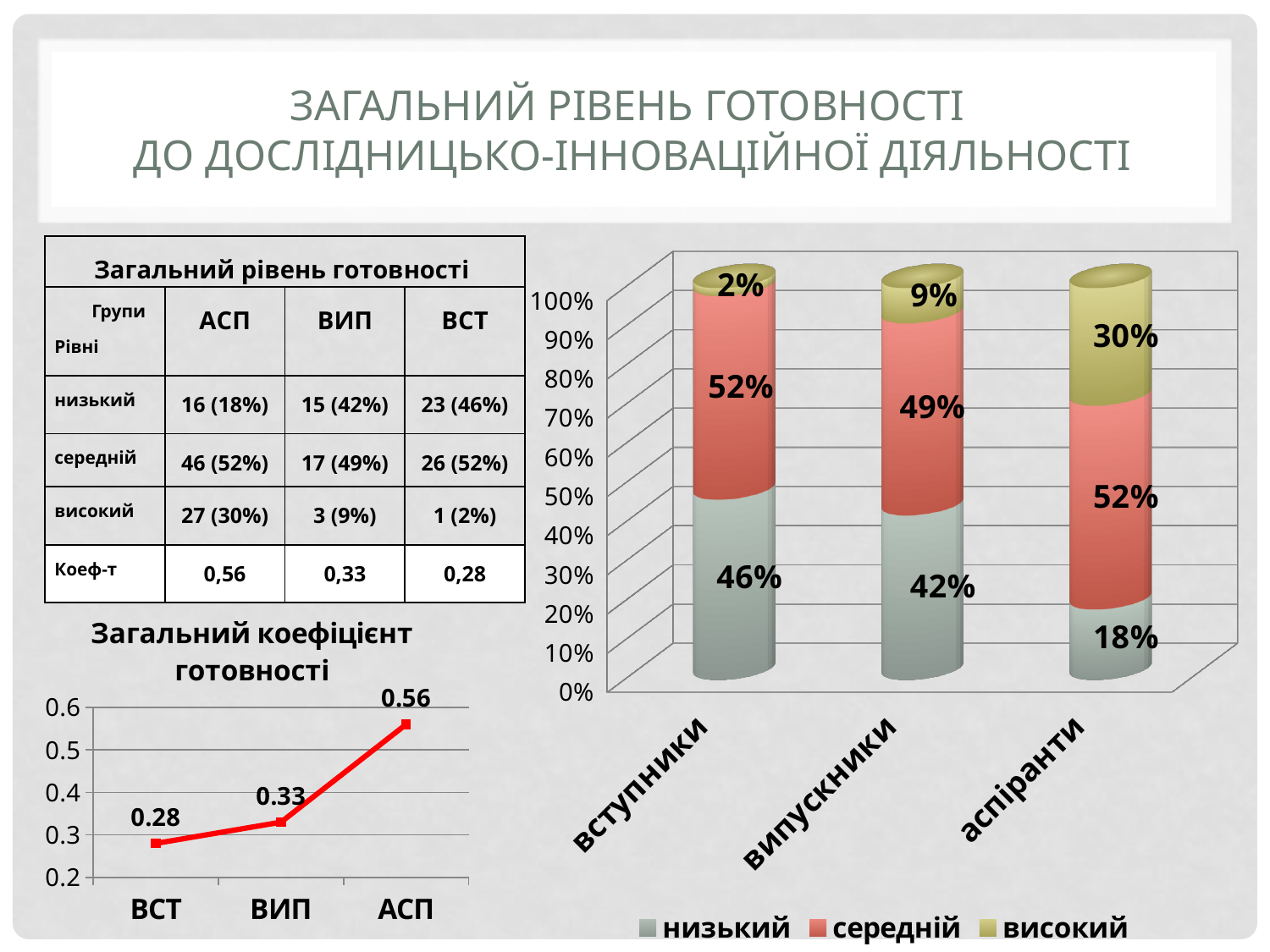
What kind of chart is the chart on the right of the slide? stacked bar chart In the line chart 'Загальний коефіцієнт готовності', how many points are plotted? 3 In the stacked bar chart on the right, what is the value of 'високий' for аспіранти? 30% In the stacked bar chart on the right, which group has the lowest 'високий' share? вступники In the stacked bar chart on the right, how many series does the legend list? 3 In the stacked bar chart on the right, is the 'низький' value larger for випускники or for аспіранти? випускники In the line chart 'Загальний коефіцієнт готовності', which group has the highest value? АСП In the line chart 'Загальний коефіцієнт готовності', what is the difference between the values for АСП and ВИП? 0.23 In the stacked bar chart on the right, what is the value of 'низький' for вступники? 46% In the line chart 'Загальний коефіцієнт готовності', do the values rise or fall from ВСТ to АСП? rise In the line chart 'Загальний коефіцієнт готовності', what is the value for ВСТ? 0.28 In the line chart 'Загальний коефіцієнт готовності', what is the value for АСП? 0.56